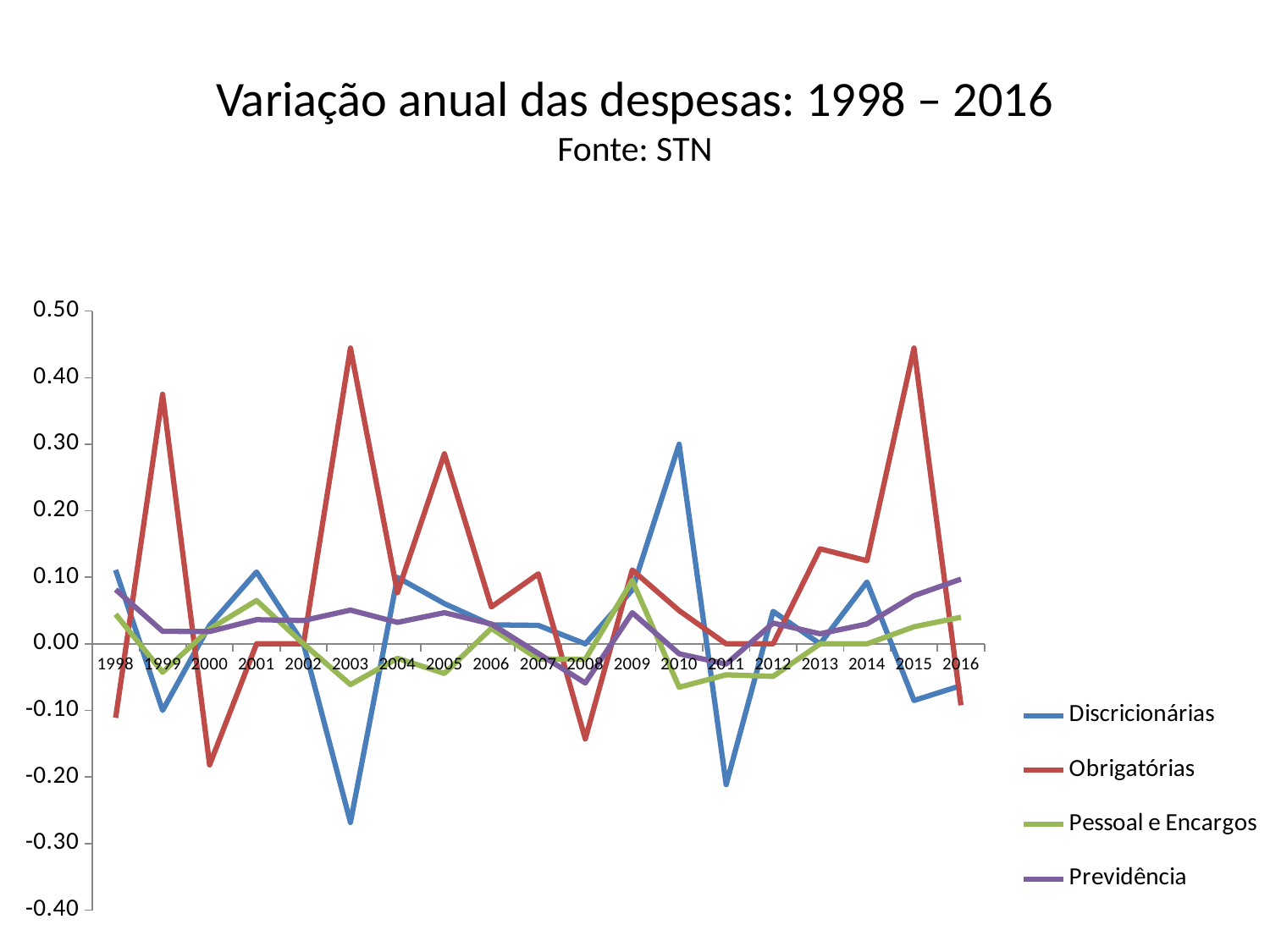
In 2010, which series has the larger value: Discricionárias or Obrigatórias? Discricionárias In which year does the Discricionárias series reach its highest value? 2010 What source is cited below the chart title? STN Is the value for Obrigatórias in 2003 greater or less than 0.40? greater How many series does the legend list? 4 Is the value for Discricionárias in 2003 greater or less than -0.20? less In 2003, which series has the larger value: Obrigatórias or Discricionárias? Obrigatórias Is the value for Discricionárias in 2010 greater or less than 0.20? greater In which year does the Discricionárias series reach its lowest value? 2003 What kind of chart is shown on the slide? line chart In which year does the Obrigatórias series reach its lowest value? 2000 How many years are plotted along the x axis? 19